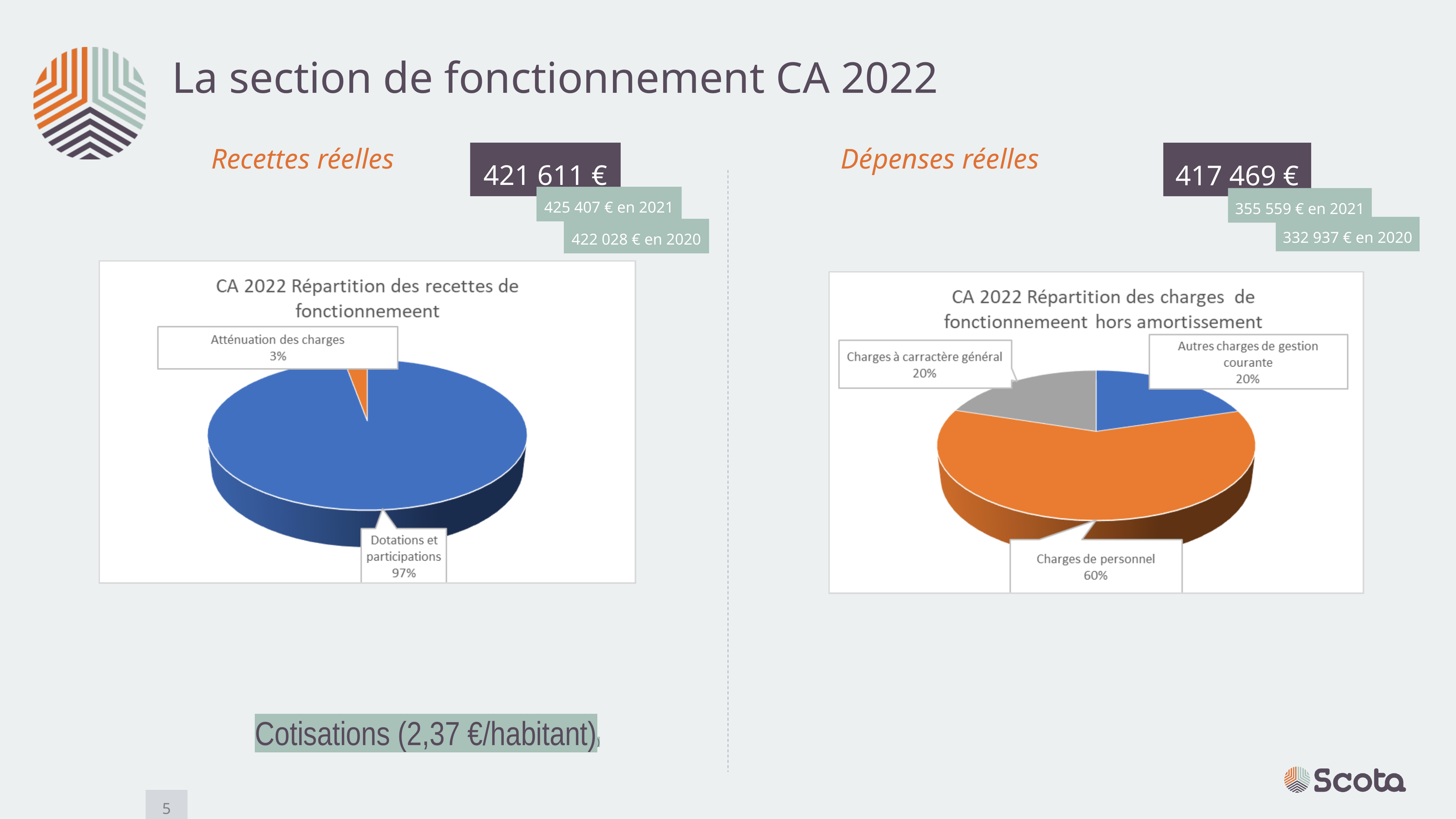
In the left chart 'CA 2022 Répartition des recettes de fonctionnemeent', how many slices does the pie have? 2 What kind of chart is the left chart 'CA 2022 Répartition des recettes de fonctionnemeent'? Pie chart In the right chart 'CA 2022 Répartition des charges de fonctionnemeent hors amortissement', what share does 'Charges de personnel' have? 60% In the right chart 'CA 2022 Répartition des charges de fonctionnemeent hors amortissement', which category has the largest slice? Charges de personnel In the left chart 'CA 2022 Répartition des recettes de fonctionnemeent', what share does 'Atténuation des charges' have? 3% In the left chart 'CA 2022 Répartition des recettes de fonctionnemeent', which category has the largest slice? Dotations et participations In the right chart 'CA 2022 Répartition des charges de fonctionnemeent hors amortissement', what colour is the 'Charges de personnel' slice? Orange In the right chart 'CA 2022 Répartition des charges de fonctionnemeent hors amortissement', what share does 'Charges à carractère général' have? 20% In the left chart 'CA 2022 Répartition des recettes de fonctionnemeent', what is the difference in share between 'Dotations et participations' and 'Atténuation des charges'? 94% In the right chart 'CA 2022 Répartition des charges de fonctionnemeent hors amortissement', what is the difference in share between 'Charges de personnel' and 'Autres charges de gestion courante'? 40% In the right chart 'CA 2022 Répartition des charges de fonctionnemeent hors amortissement', how many slices does the pie have? 3